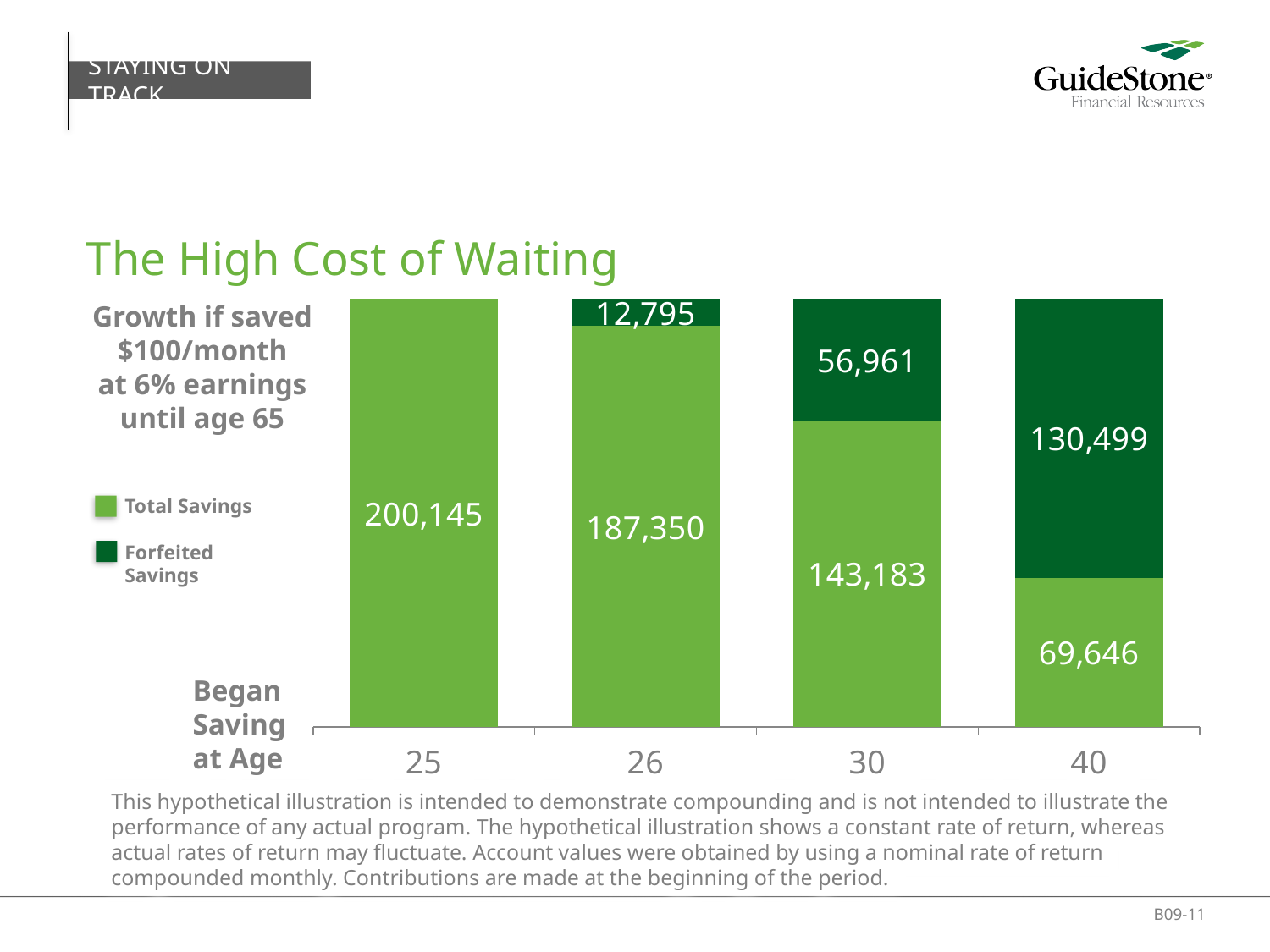
What is the Total Savings value for someone who began saving at age 40? 69,646 Which starting age has the highest Total Savings? 25 What is the Forfeited Savings value for someone who began saving at age 26? 12,795 Which starting age has the largest Forfeited Savings? 40 How many series does the legend list? 2 What is the combined total of Total Savings and Forfeited Savings for the age 40 bar? 200,145 Is the Total Savings larger for starting at age 26 or at age 30? 26 What is the Total Savings value for someone who began saving at age 25? 200,145 Which starting age has the lowest Total Savings? 40 What is the difference in Forfeited Savings between starting at age 40 and starting at age 30? 73,538 What is the Forfeited Savings value for someone who began saving at age 30? 56,961 What is the difference in Total Savings between starting at age 25 and starting at age 40? 130,499